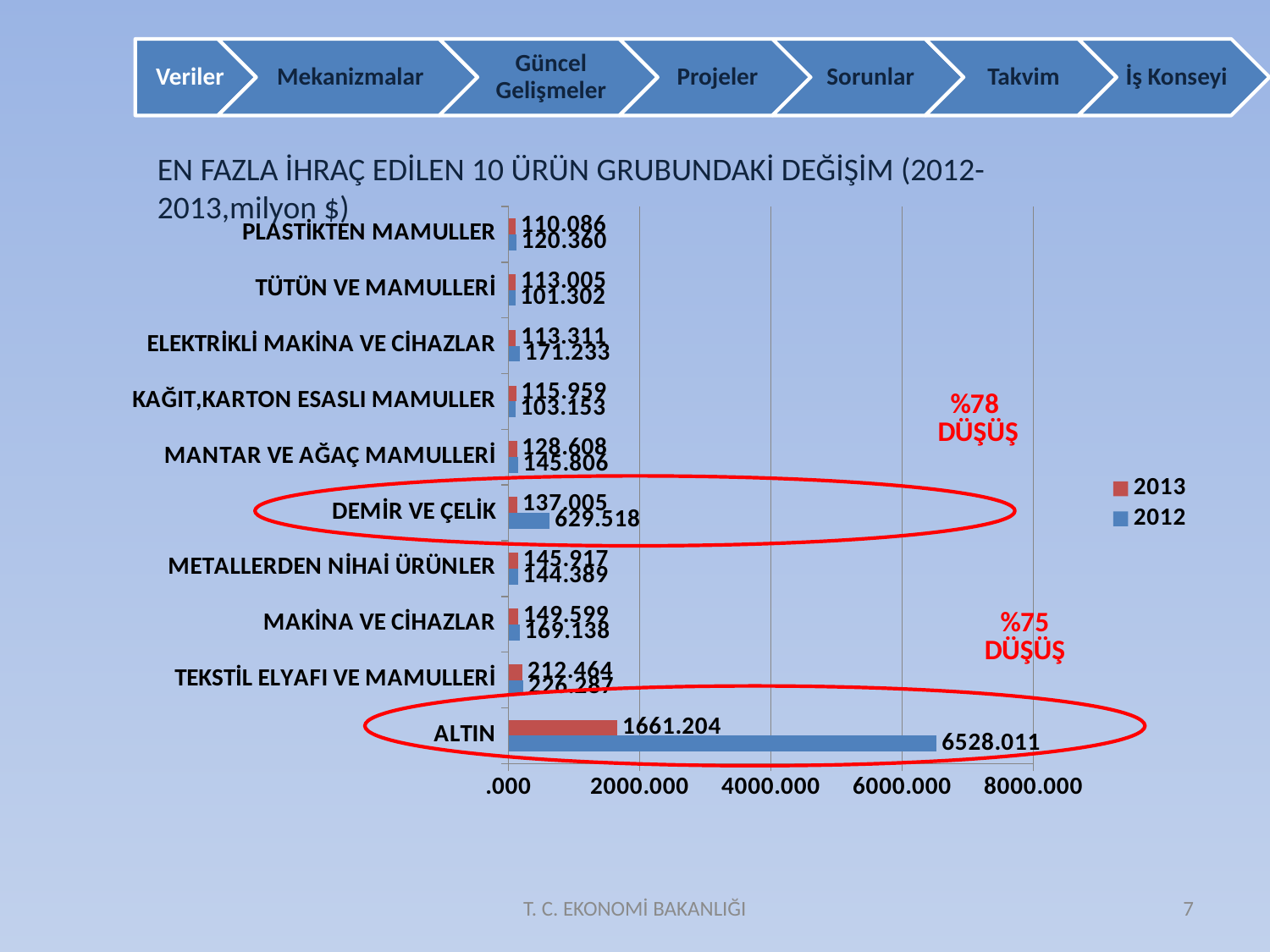
What is the 2013 value for DEMİR VE ÇELİK? 137.005 What kind of chart is shown on the slide? bar chart How many product groups (categories) are shown in the chart? 10 What is the 2013 value for ALTIN? 1661.204 How many series does the legend list? 2 What is the 2012 value for ALTIN? 6528.011 Is the 2012 value for ALTIN greater or less than 6000.000? greater What is the difference between the 2012 and 2013 values for ALTIN? 4866.807 What is the 2012 value for DEMİR VE ÇELİK? 629.518 For ALTIN, which year has the larger value, 2012 or 2013? 2012 What are the two entries in the chart's legend? 2013 and 2012 Which product group has the highest 2012 value? ALTIN